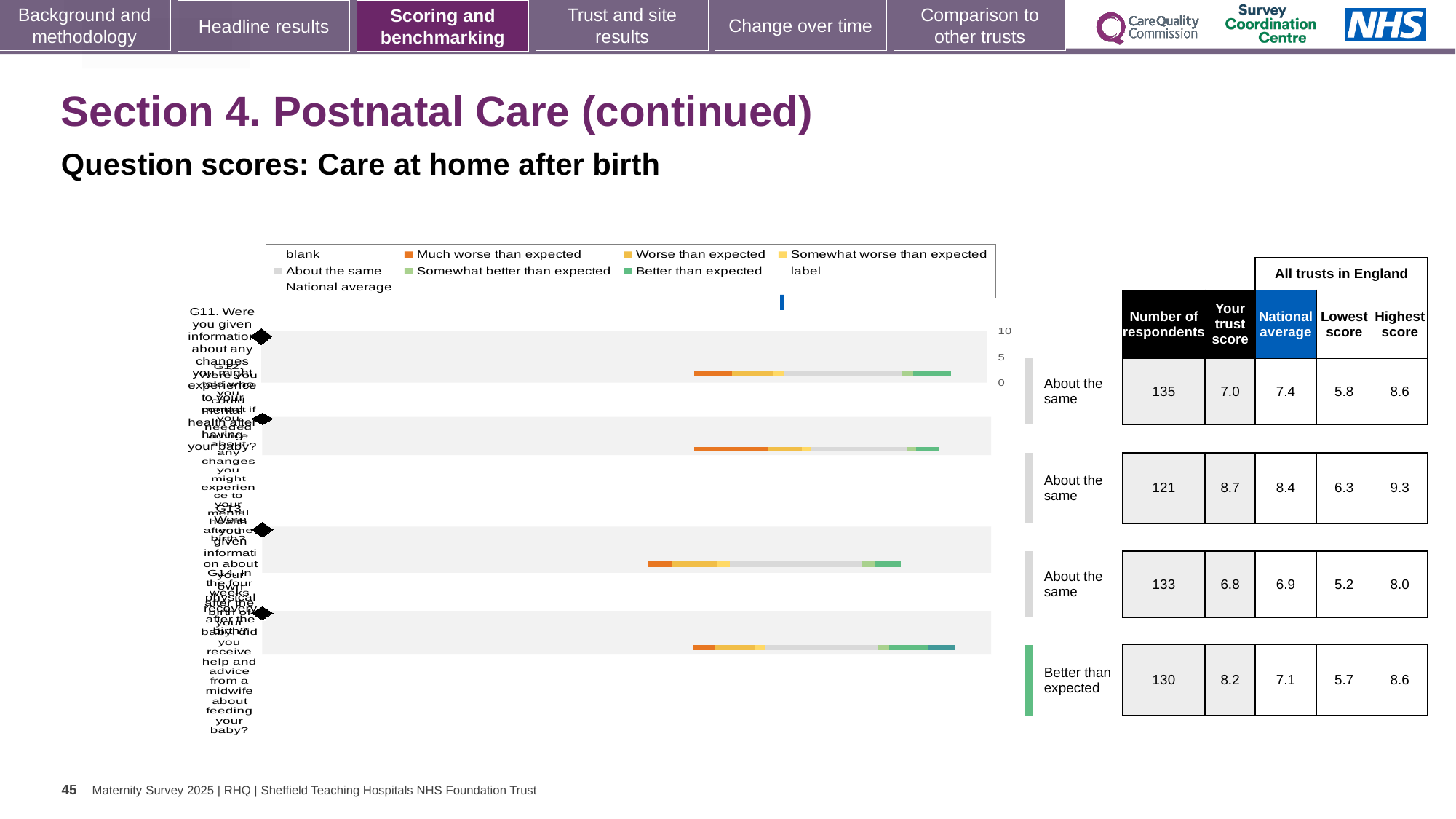
What is the 'Lowest score' for the third row in the table? 5.2 What is the 'Highest score' for the second row in the table? 9.3 Which row has the highest 'Your trust score' in the table? the second row (8.7) For the fourth (bottom) row, what is the difference between 'Your trust score' and the 'National average'? 1.1 In the table next to the chart, what is the number of respondents for the first (top) row? 135 What kind of chart is shown on the slide? bar chart Which row has the lowest 'National average' in the table? the third row (6.9) For the first (top) row, which is larger: 'Your trust score' or the 'National average'? National average How many question rows (bars) are plotted in the chart? 4 Which row is rated 'Better than expected' rather than 'About the same'? the fourth (bottom) row What colour does the legend use for 'Better than expected'? green In the table next to the chart, what is the 'Your trust score' for the second row? 8.7